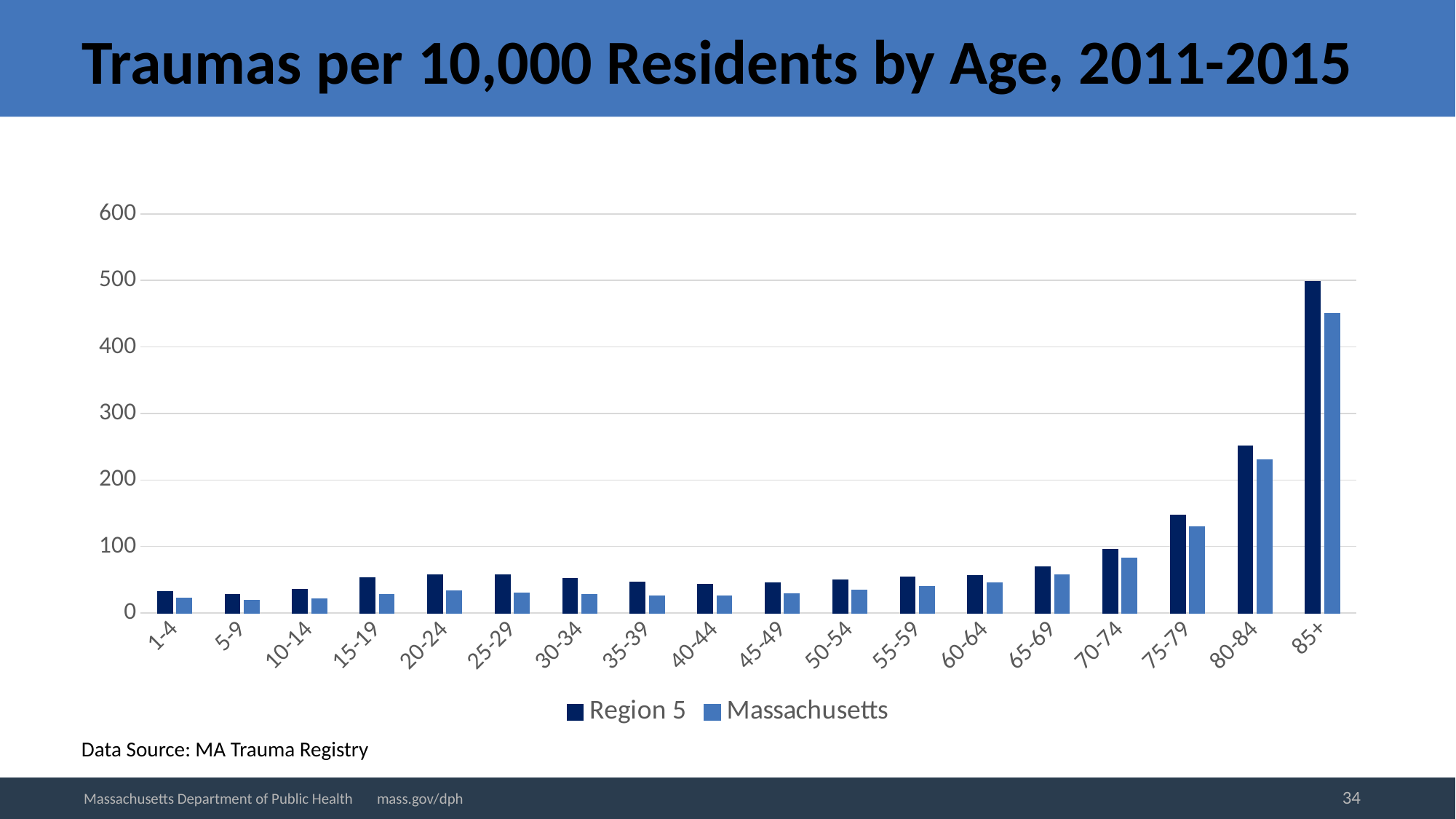
Is the Massachusetts value for the 85+ age group greater or less than 400? greater Which age group has the highest value for Region 5? 85+ Is the Massachusetts value for the 75-79 age group greater or less than 100? greater What kind of chart is shown on the slide? bar chart For the 85+ age group, which is larger: Region 5 or Massachusetts? Region 5 How many series does the legend list? 2 Which age group has the highest value for Massachusetts? 85+ Is the Region 5 value for the 65-69 age group greater or less than 100? less For the 20-24 age group, which is larger: Region 5 or Massachusetts? Region 5 Do the values generally rise or fall as age increases from 60-64 to 85+? rise How many age groups are shown on the x axis? 18